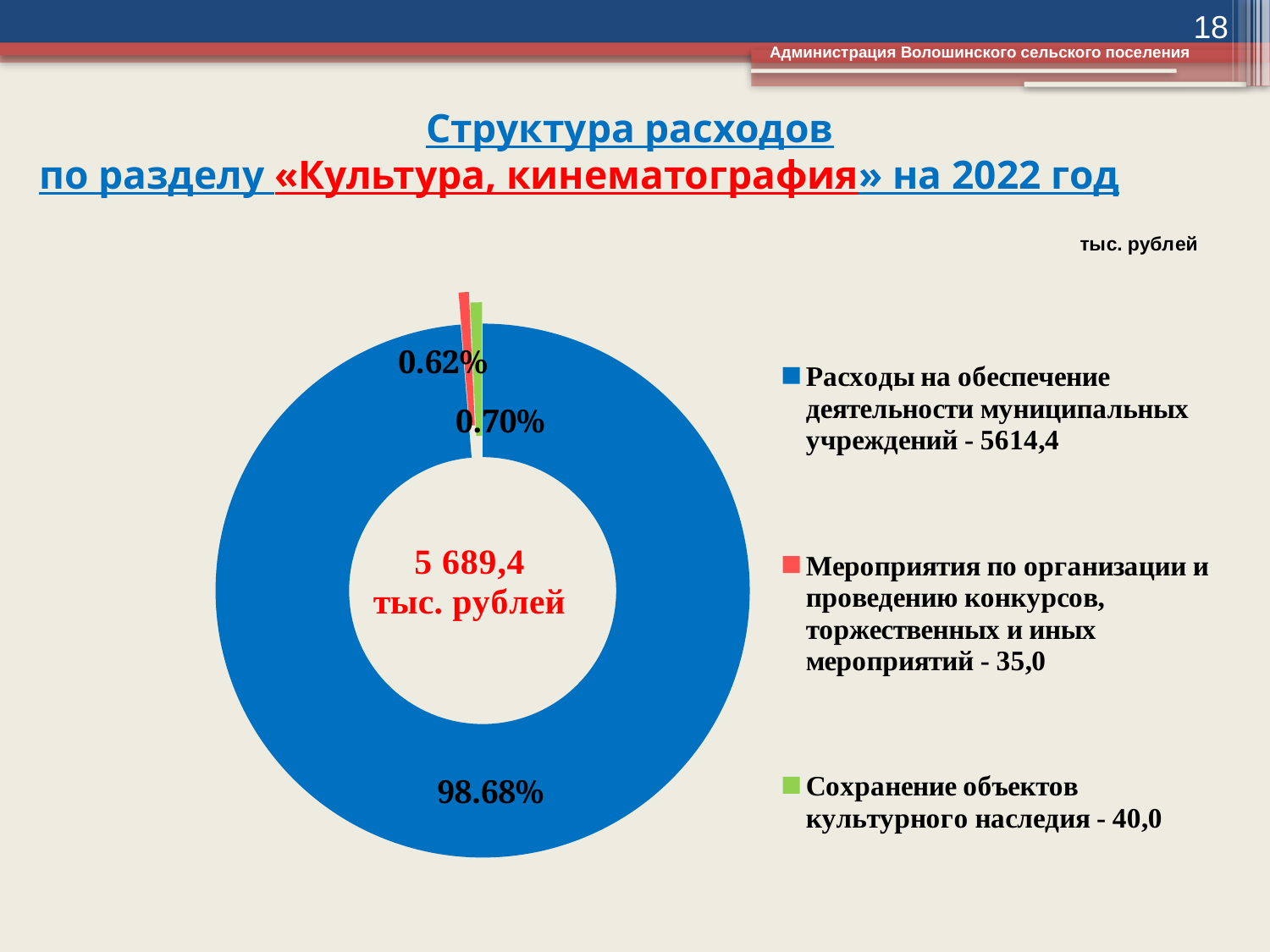
What value (тыс. рублей) is given in the legend for «Сохранение объектов культурного наследия»? 40,0 What total amount is shown in the centre of the chart? 5 689,4 тыс. рублей What value (тыс. рублей) is given in the legend for «Мероприятия по организации и проведению конкурсов, торжественных и иных мероприятий»? 35,0 What value (тыс. рублей) is given in the legend for «Расходы на обеспечение деятельности муниципальных учреждений»? 5614,4 What share of the chart is labelled for «Сохранение объектов культурного наследия»? 0.70% Which category has the largest share of the chart? Расходы на обеспечение деятельности муниципальных учреждений What share of the chart is labelled for «Расходы на обеспечение деятельности муниципальных учреждений»? 98.68% How many entries does the legend list? 3 Which category has the smallest share of the chart? Мероприятия по организации и проведению конкурсов, торжественных и иных мероприятий What share of the chart is labelled for «Мероприятия по организации и проведению конкурсов, торжественных и иных мероприятий»? 0.62% How many slices does the chart have? 3 What kind of chart is shown on the slide? Doughnut (pie) chart